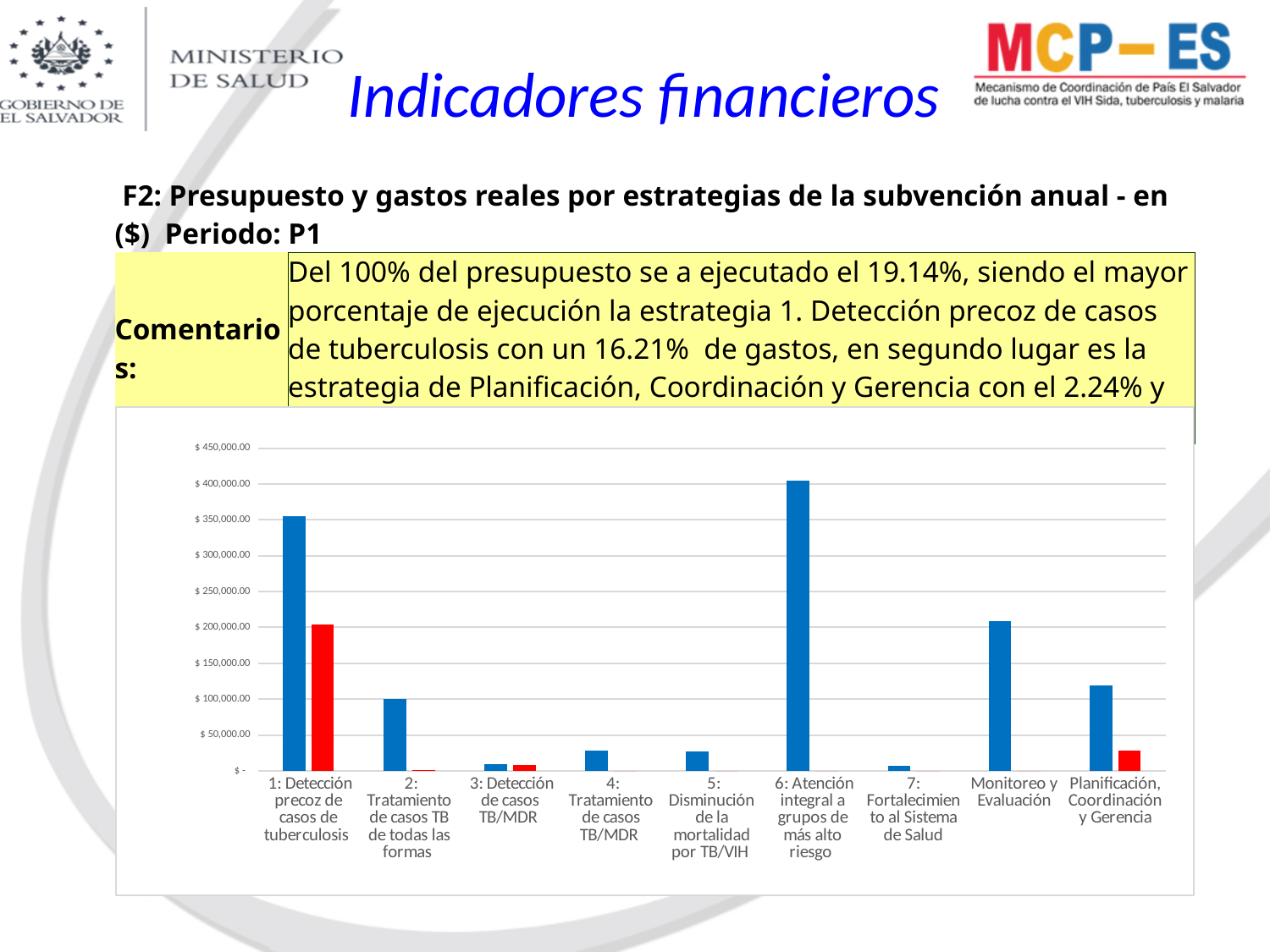
Which category has the tallest blue bar in the chart? 6: Atención integral a grupos de más alto riesgo Is the red bar for '1: Detección precoz de casos de tuberculosis' greater or less than $150,000.00? greater What is the highest value shown on the chart's y axis? $ 450,000.00 Which is larger: the blue bar for 'Monitoreo y Evaluación' or the blue bar for 'Planificación, Coordinación y Gerencia'? Monitoreo y Evaluación Is the blue bar for 'Planificación, Coordinación y Gerencia' greater or less than $100,000.00? greater Is the blue bar for '7: Fortalecimiento al Sistema de Salud' greater or less than $50,000.00? less What kind of chart is shown on the slide? bar chart How many data series (bar colours) are plotted in the chart? 2 Which is larger: the blue bar for '1: Detección precoz de casos de tuberculosis' or the blue bar for '6: Atención integral a grupos de más alto riesgo'? 6: Atención integral a grupos de más alto riesgo How many categories (strategies) are shown on the x axis of the chart? 9